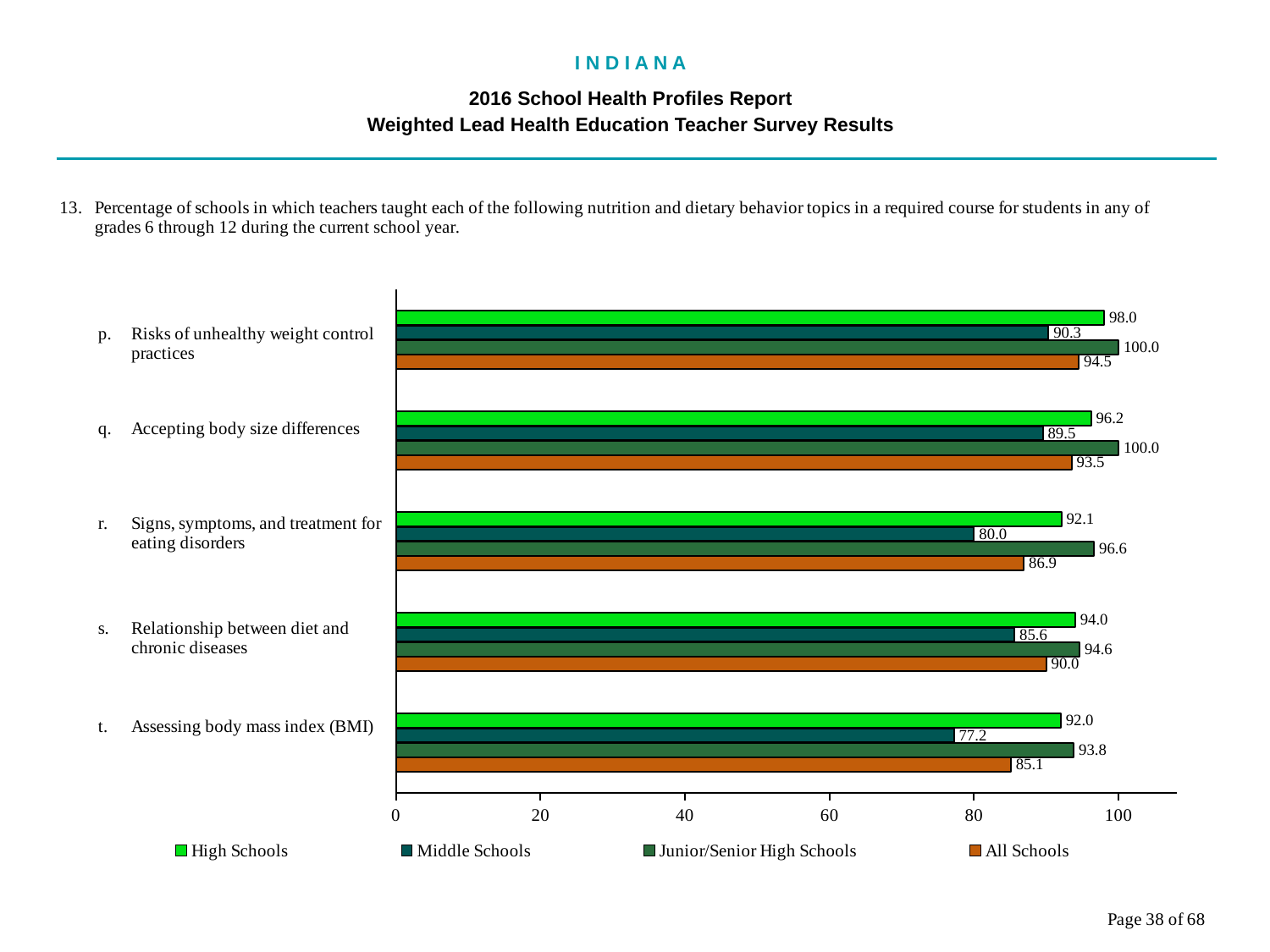
What is the difference between the High Schools and Middle Schools values for "Signs, symptoms, and treatment for eating disorders"? 12.1 Which topic has the lowest value for Middle Schools? Assessing body mass index (BMI) Is the Middle Schools value for "Assessing body mass index (BMI)" greater or less than 80? less What is the value for All Schools for "Signs, symptoms, and treatment for eating disorders"? 86.9 How many series does the legend list? 4 How many topics are shown on the chart? 5 Which topic has the highest value for All Schools? Risks of unhealthy weight control practices What is the value for Middle Schools for "Assessing body mass index (BMI)"? 77.2 What is the value for High Schools for "Risks of unhealthy weight control practices"? 98.0 What kind of chart is shown on the slide? Bar chart For "Accepting body size differences", which is larger: the High Schools value or the Middle Schools value? High Schools What is the value for Junior/Senior High Schools for "Relationship between diet and chronic diseases"? 94.6